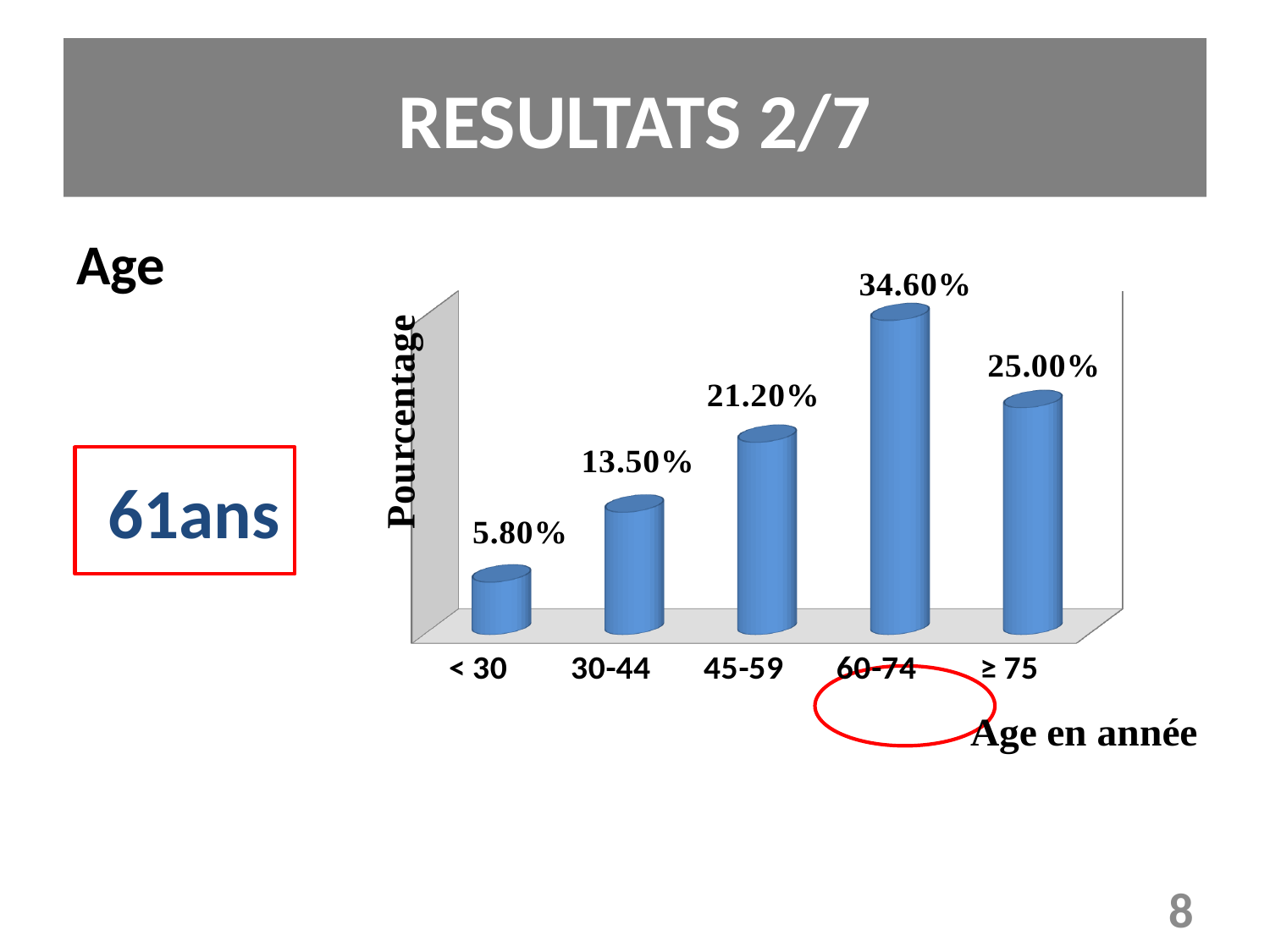
Which is larger, the value for 45-59 or the value for ≥ 75? ≥ 75 What is the value for the ≥ 75 age group? 25.00% Which age group has the highest percentage? 60-74 What is the value for the < 30 age group? 5.80% What is the difference between the values for 30-44 and < 30? 7.70% What kind of chart is shown on the slide? Bar chart What is the value for the 60-74 age group? 34.60% What is the difference between the values for 60-74 and ≥ 75? 9.60% Which age group has the lowest percentage? < 30 What is the value for the 45-59 age group? 21.20% How many age groups are shown on the x axis? 5 What is the label of the vertical axis? Pourcentage